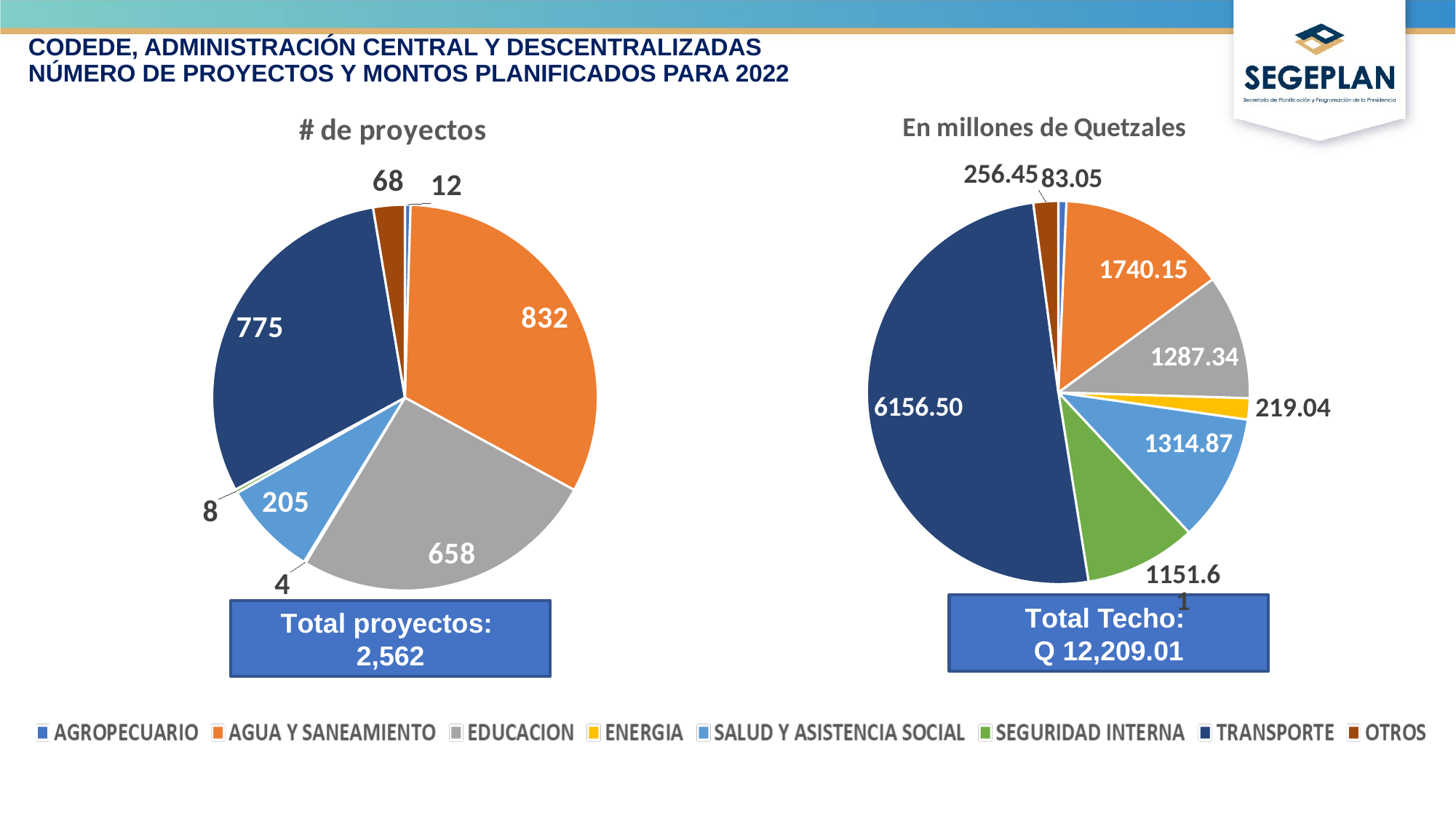
In the 'En millones de Quetzales' pie chart, what is the value for TRANSPORTE? 6156.50 In the 'En millones de Quetzales' pie chart, which is larger: SALUD Y ASISTENCIA SOCIAL or EDUCACION? SALUD Y ASISTENCIA SOCIAL What kind of chart is the '# de proyectos' chart? Pie chart In the 'En millones de Quetzales' pie chart, which category has the smallest amount? AGROPECUARIO How many categories does the legend list? 8 In the '# de proyectos' pie chart, how many projects are in AGUA Y SANEAMIENTO? 832 In the 'En millones de Quetzales' pie chart, which category has the largest amount? TRANSPORTE In the '# de proyectos' pie chart, how many projects are in TRANSPORTE? 775 In the '# de proyectos' pie chart, how many more projects does AGUA Y SANEAMIENTO have than TRANSPORTE? 57 In the 'En millones de Quetzales' pie chart, what is the value for EDUCACION? 1287.34 In the '# de proyectos' pie chart, which category has the most projects? AGUA Y SANEAMIENTO In the '# de proyectos' pie chart, which category has the fewest projects? ENERGIA